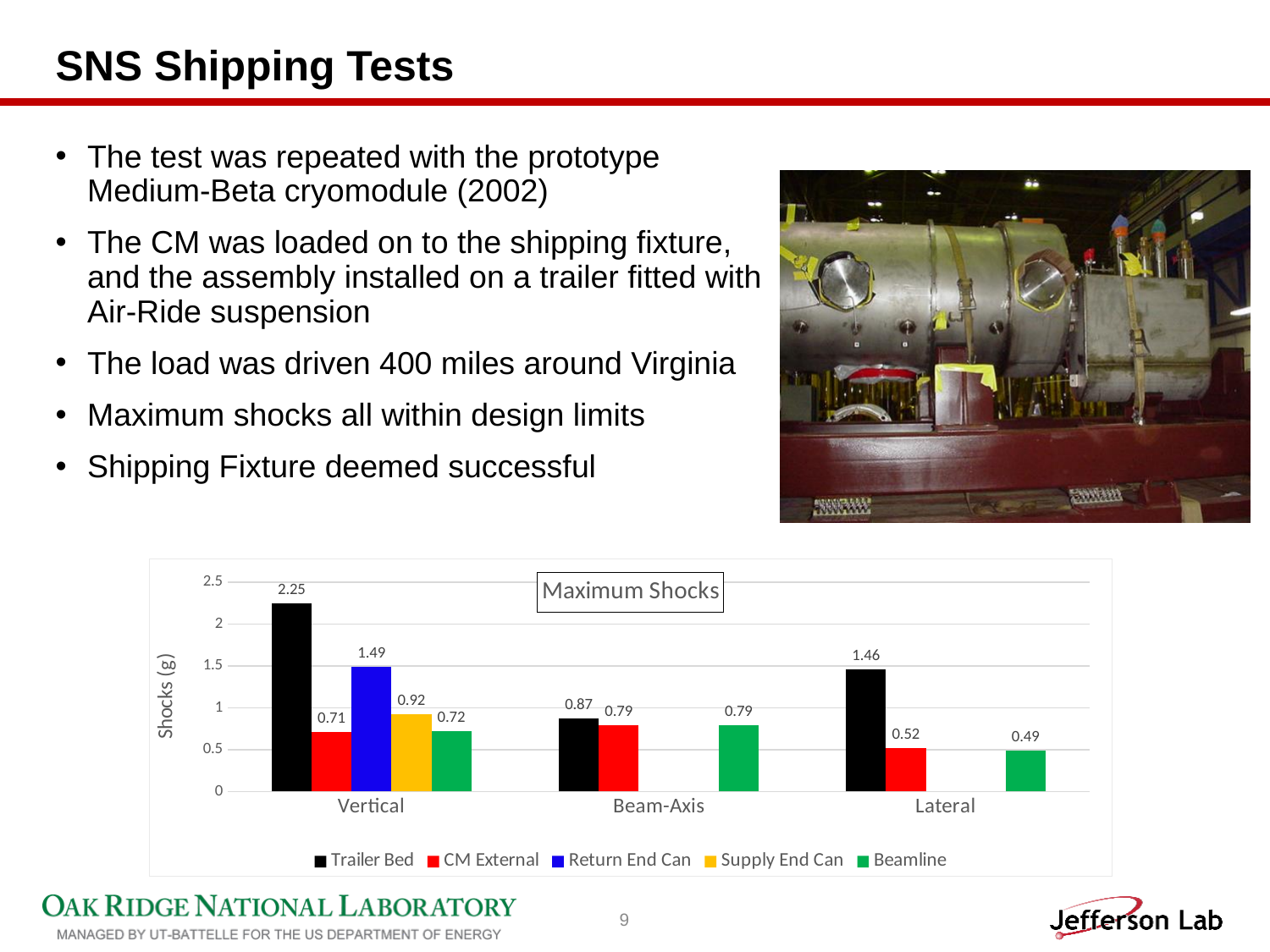
In the Maximum Shocks chart, what is the Beamline value for Lateral? 0.49 In the Maximum Shocks chart, what is the difference between the Trailer Bed values for Vertical and Lateral? 0.79 In the Maximum Shocks chart, which series has the lowest value for Lateral? Beamline In the Maximum Shocks chart, what is the Return End Can value for Vertical? 1.49 In the Maximum Shocks chart, which is larger: the Supply End Can value for Vertical or the Beamline value for Vertical? Supply End Can In the Maximum Shocks chart, what is the CM External value for Beam-Axis? 0.79 What is the y-axis label of the Maximum Shocks chart? Shocks (g) How many categories are shown on the x axis of the Maximum Shocks chart? 3 What type of chart is shown under the title "Maximum Shocks"? bar chart In the Maximum Shocks chart, which series has the highest value for Vertical? Trailer Bed In the Maximum Shocks chart, what is the Trailer Bed value for Vertical? 2.25 How many series does the legend of the Maximum Shocks chart list? 5